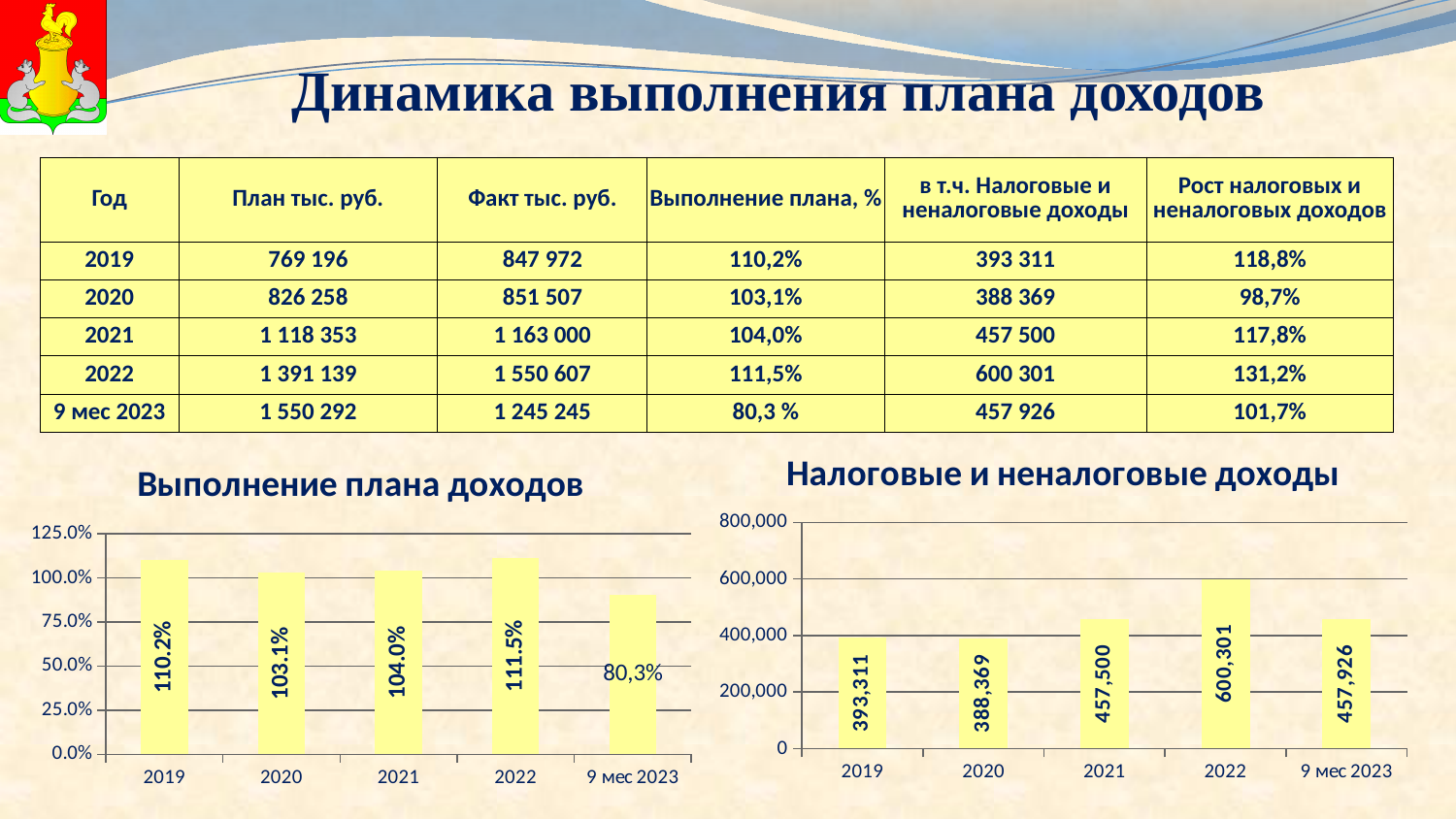
In the chart 'Выполнение плана доходов', what is the value for 2019? 110.2% In the chart 'Налоговые и неналоговые доходы', what is the value for 2020? 388,369 In the chart 'Выполнение плана доходов', which is larger, the value for 2021 or the value for 2020? 2021 In the chart 'Налоговые и неналоговые доходы', do the values rise or fall from 2020 to 2022? rise In the chart 'Выполнение плана доходов', what is the value for 9 мес 2023? 80,3% How many categories are shown on the x axis of the chart 'Выполнение плана доходов'? 5 In the chart 'Налоговые и неналоговые доходы', what is the difference between the values for 2022 and 2021? 142,801 In the chart 'Налоговые и неналоговые доходы', is the value for 2022 greater or less than 400,000? greater What kind of chart is 'Налоговые и неналоговые доходы'? bar chart In the chart 'Выполнение плана доходов', which category has the lowest value? 9 мес 2023 In the chart 'Налоговые и неналоговые доходы', what is the value for 2022? 600,301 In the chart 'Налоговые и неналоговые доходы', which category has the highest value? 2022